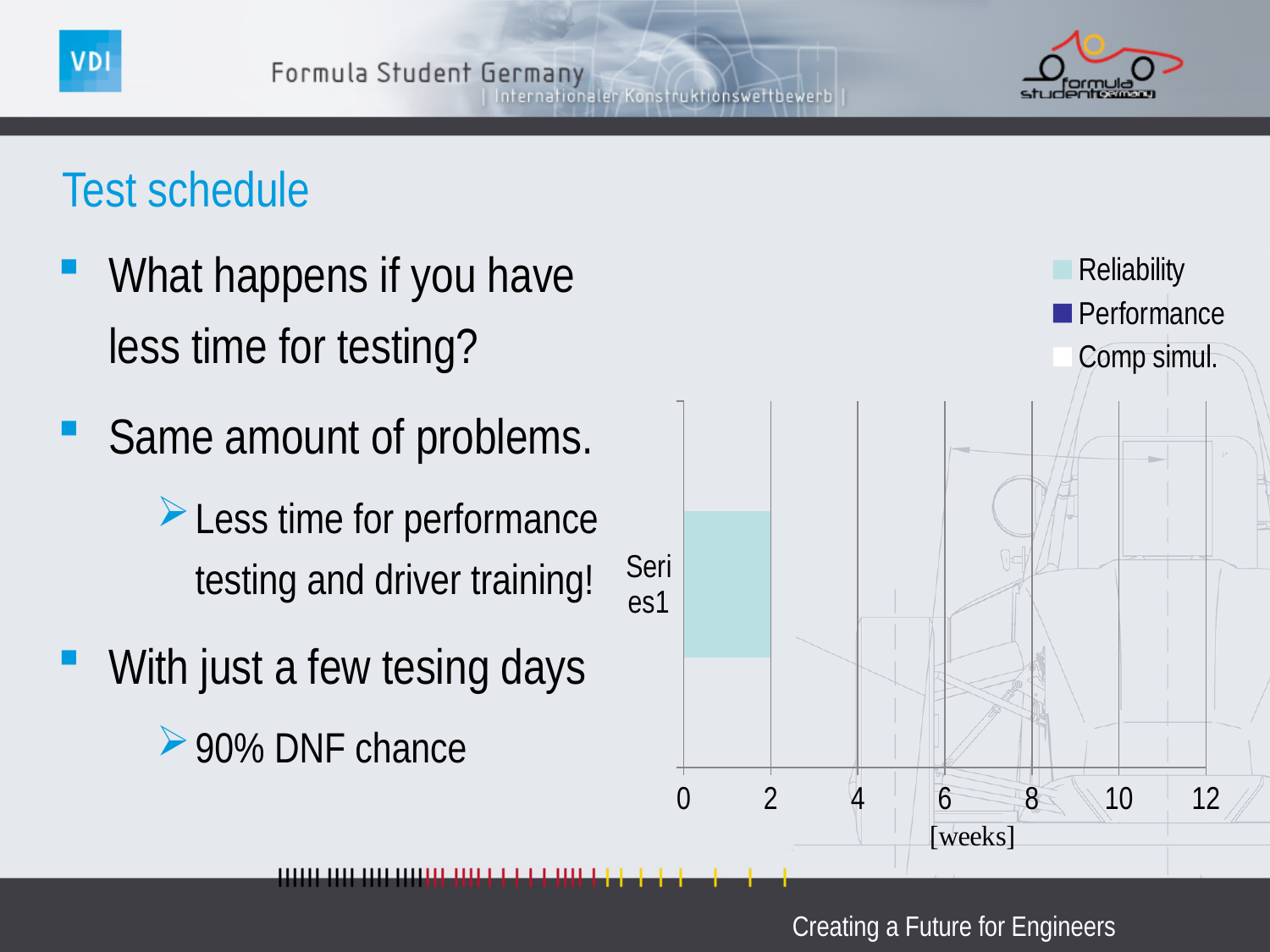
What unit is shown on the chart's horizontal axis? [weeks] Is the Reliability value for Series1 greater or less than 6 weeks? less How many series does the chart legend list? 3 What are the three series named in the chart legend? Reliability, Performance, Comp simul. Is the Reliability value for Series1 greater or less than 4 weeks? less What kind of chart is shown on the slide? bar chart What is the highest tick value shown on the chart's horizontal axis? 12 At what value on the horizontal axis does the Reliability bar for Series1 end? 2 Which legend series is drawn in dark blue? Performance What is the label of the single category on the chart's vertical axis? Series1 How many categories are plotted on the chart's vertical axis? 1